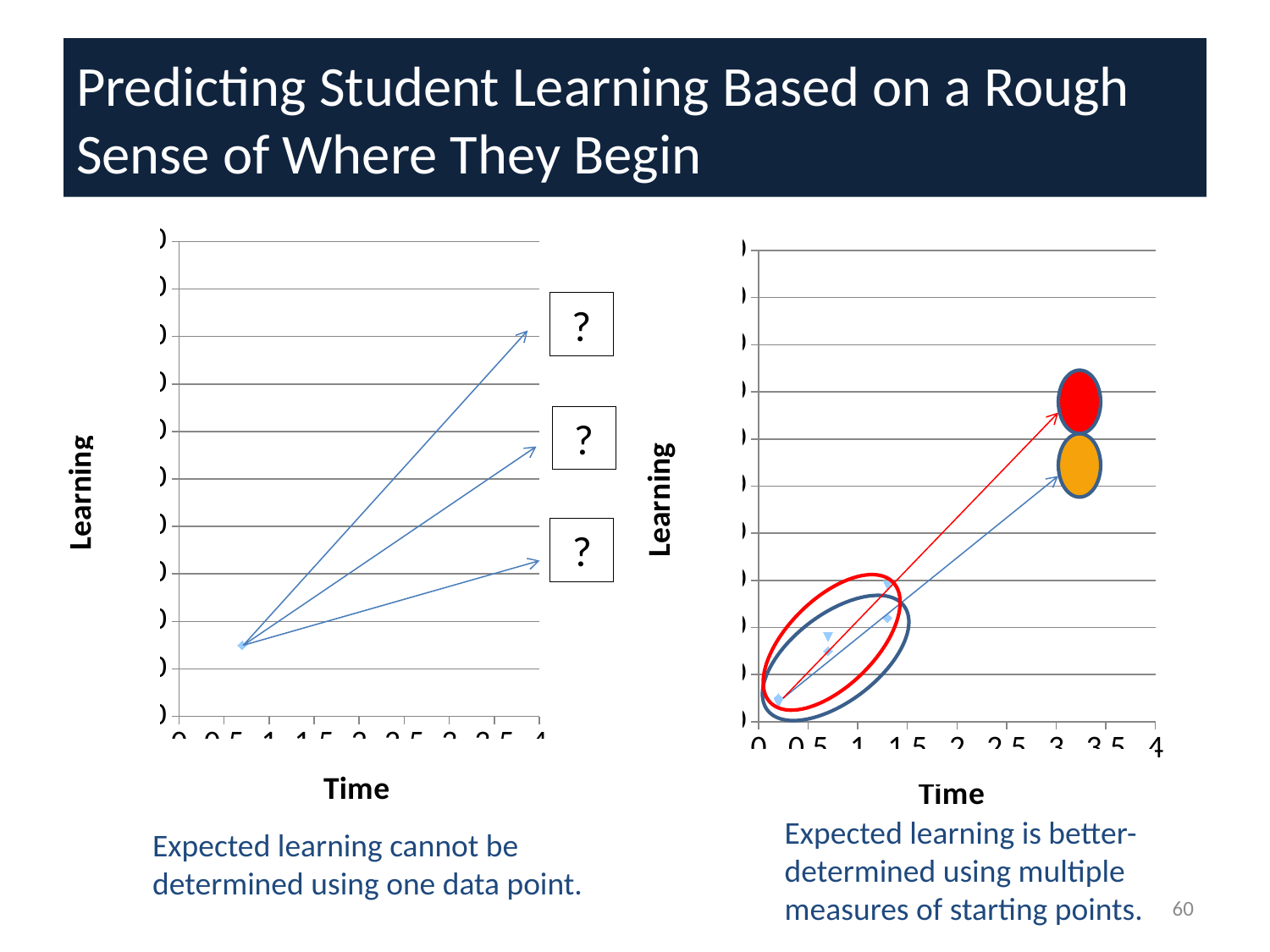
On the left chart, is the Time value of the plotted data point greater or less than 1? less What kind of chart is the left chart on the slide? scatter chart How many data points are plotted on the left chart? 1 On the right chart, are all the plotted data points at Time values less than 2? yes How many charts are shown on the slide? 2 On the right chart, what is the title of the y axis? Learning On the left chart, what is the title of the x axis? Time What kind of chart is the right chart on the slide? scatter chart On the right chart, what is the highest tick value shown on the Time axis? 4